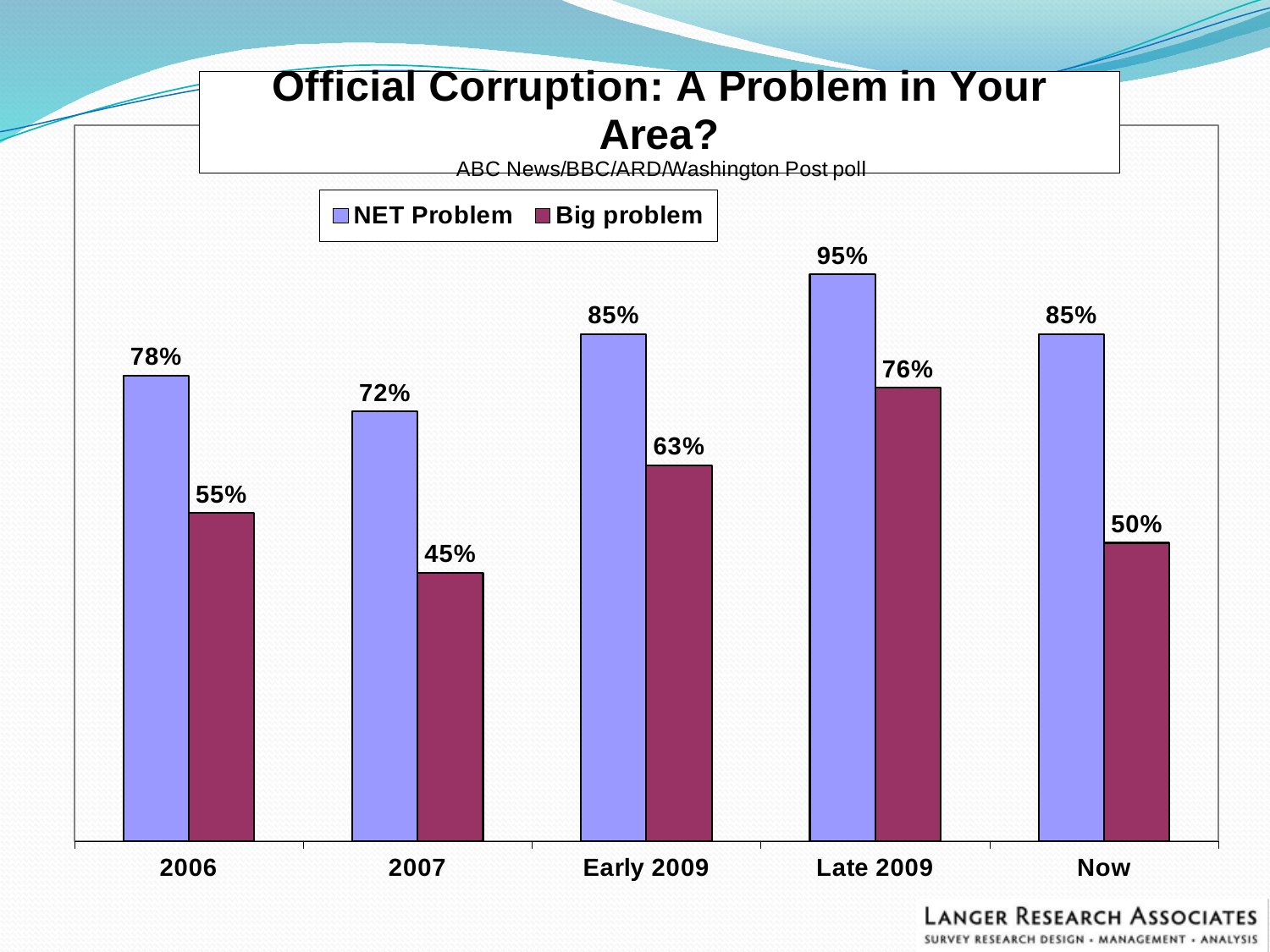
How many categories are shown on the x axis? 5 How many series does the legend list? 2 What is the difference between the NET Problem and Big problem values for 2006? 23% What is the Big problem value for 2007? 45% Which category has the highest NET Problem value? Late 2009 What is the Big problem value for Now? 50% What is the NET Problem value for Late 2009? 95% What kind of chart is shown on the slide? Bar chart Which is larger, the Big problem value for Early 2009 or for 2006? Early 2009 Which poll is cited as the source of the chart? ABC News/BBC/ARD/Washington Post poll What is the difference between the Big problem values for Late 2009 and Now? 26% Which category has the lowest Big problem value? 2007